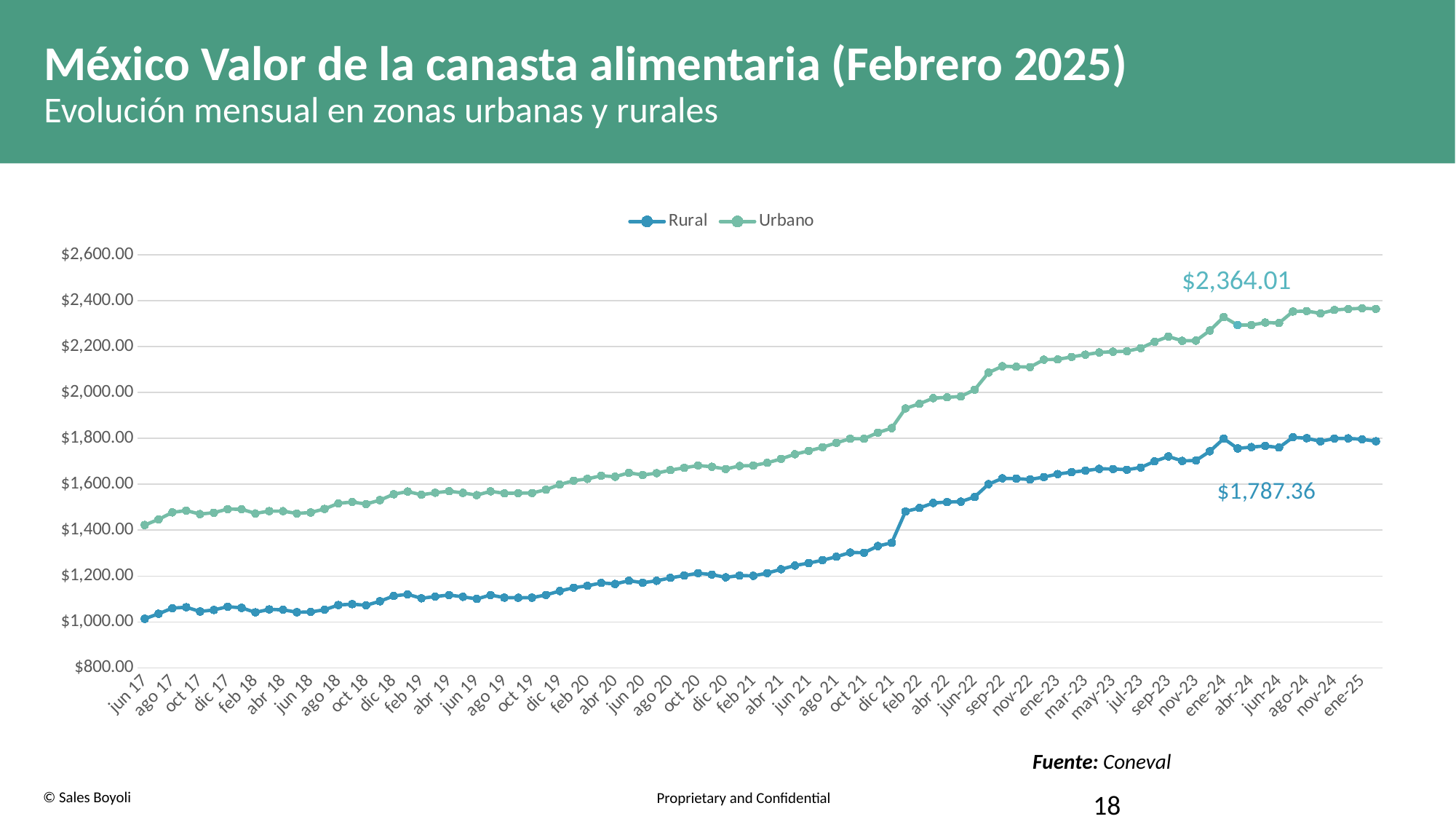
How many series does the legend list? 2 What is the labelled value of the Rural series at its final point? $1,787.36 What kind of chart is shown on the slide? line chart At the final point, which series has the larger value, Rural or Urbano? Urbano Is the value for Rural at jun 17 greater or less than $1,200.00? less Is the value for Rural at feb 22 greater or less than $1,400.00? greater What is the labelled value of the Urbano series at its final point? $2,364.01 What are the two series names shown in the legend? Rural and Urbano Is the value for Urbano at jun 17 greater or less than $1,600.00? less Do the values of the Rural series generally rise or fall from jun 17 to the end of the chart? rise What is the difference between the labelled final values of the Urbano and Rural series? $576.65